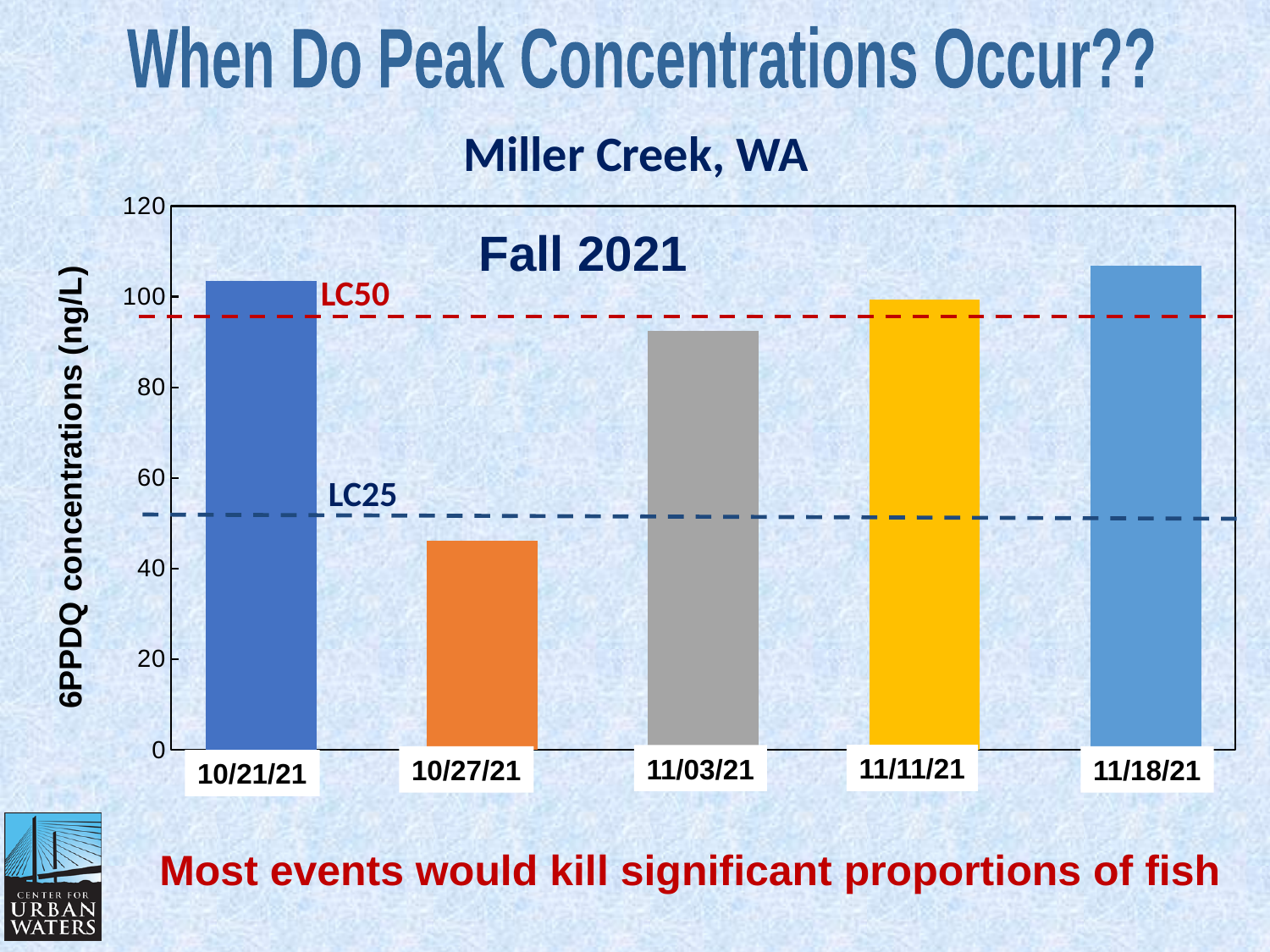
Which is larger, the value for 10/21/21 or the value for 10/27/21? 10/21/21 Is the value for 11/03/21 greater or less than 100? less Is the value for 10/27/21 greater or less than 40? greater What kind of chart is shown on the slide? bar chart What is the label on the y axis of the chart? 6PPDQ concentrations (ng/L) Is the value for 11/11/21 greater or less than 80? greater Which date has the lowest 6PPDQ concentration? 10/27/21 How many dates (bars) are plotted in the chart? 5 What are the two dashed horizontal reference lines on the chart labelled? LC50 and LC25 Which is larger, the value for 11/18/21 or the value for 11/03/21? 11/18/21